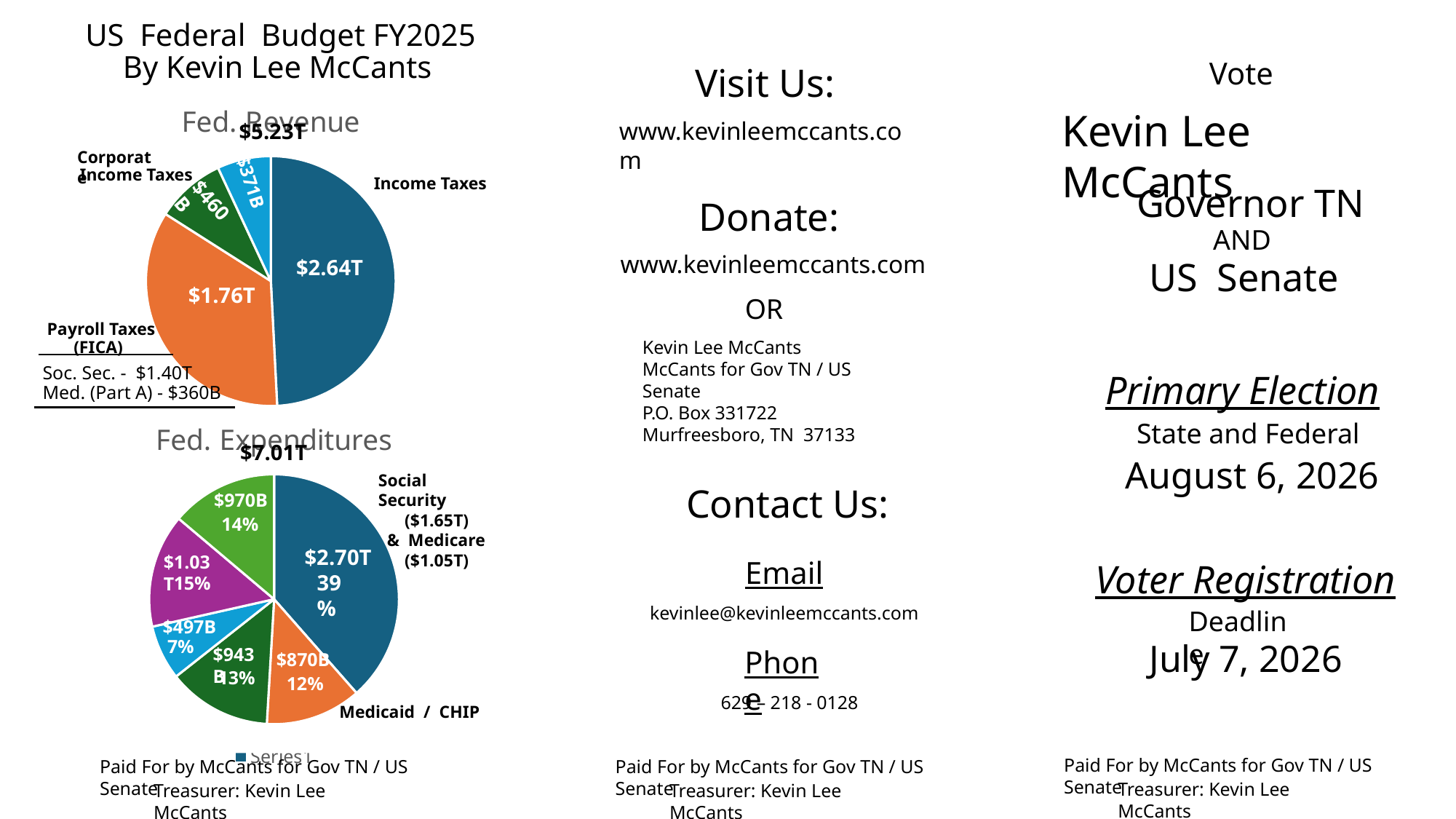
In the Fed. Expenditures chart, what share of the pie is Medicaid / CHIP? 12% In the Fed. Revenue chart, what is the value for Corporate Income Taxes? $460B In the Fed. Revenue chart, which category has the largest slice? Income Taxes In the Fed. Revenue chart, which is larger, Income Taxes or Payroll Taxes (FICA)? Income Taxes In the Fed. Expenditures chart, what is the value for Social Security & Medicare? $2.70T In the Fed. Revenue chart, what is the value for Income Taxes? $2.64T In the Fed. Revenue chart, what is the value for Payroll Taxes (FICA)? $1.76T How many slices does the Fed. Expenditures pie chart have? 6 In the Fed. Expenditures chart, what share of the pie is Social Security & Medicare? 39% How many slices does the Fed. Revenue pie chart have? 4 In the Fed. Expenditures chart, what is the value for Medicaid / CHIP? $870B What kind of chart is the Fed. Revenue chart? Pie chart